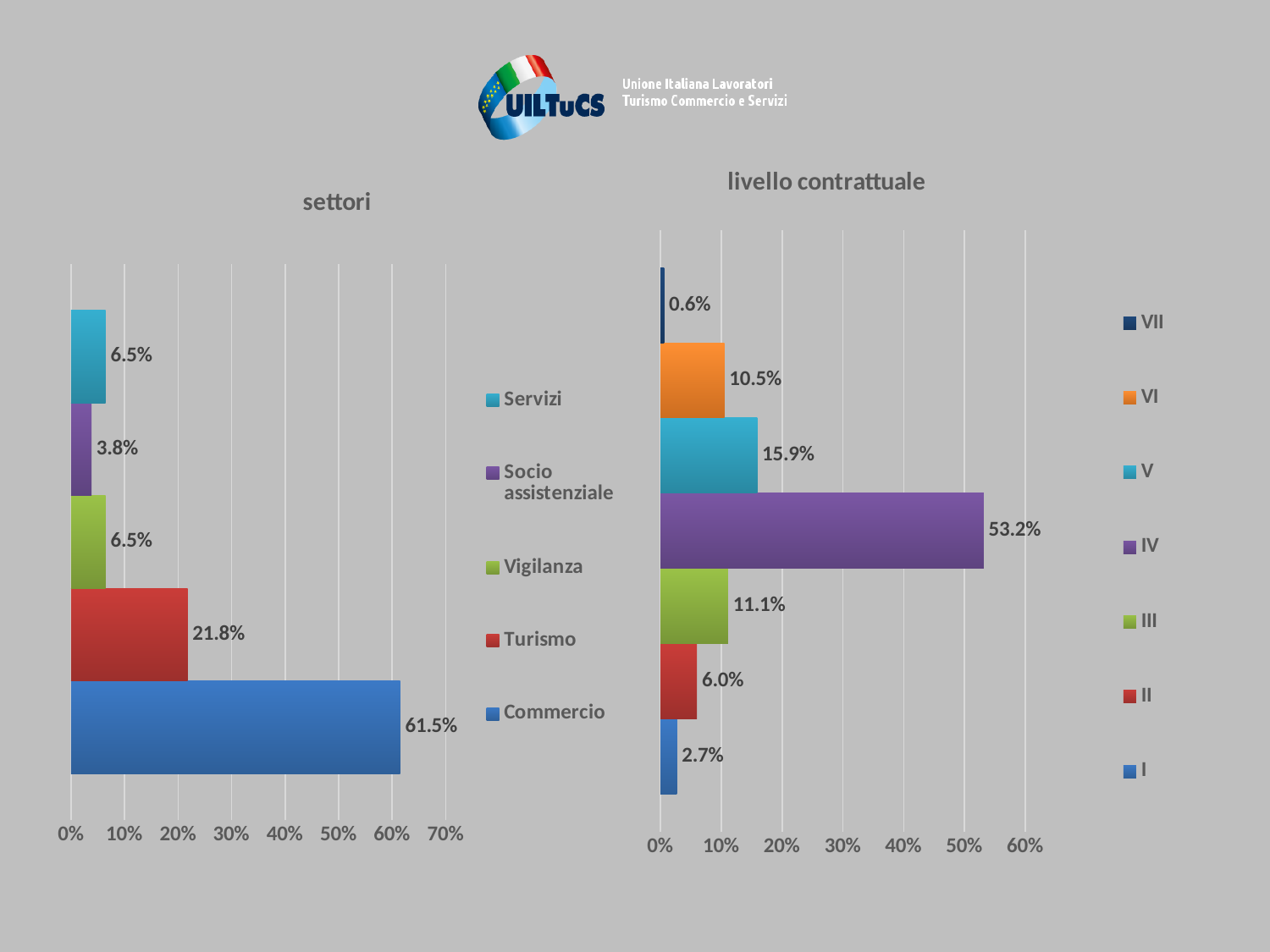
In the 'livello contrattuale' chart, which is larger, level V or level VI? V In the 'livello contrattuale' chart, how many levels does the legend list? 7 In the 'settori' chart, which sector has the lowest value? Socio assistenziale In the 'settori' chart, what is the value for Commercio? 61.5% In the 'livello contrattuale' chart, which level has the highest value? IV In the 'settori' chart, what is the difference between Commercio and Turismo? 39.7% In the 'livello contrattuale' chart, what is the value for level VII? 0.6% In the 'livello contrattuale' chart, what is the value for level IV? 53.2% In the 'settori' chart, what is the value for Turismo? 21.8% In the 'livello contrattuale' chart, what is the difference between level V and level III? 4.8% In the 'settori' chart, how many sectors are shown? 5 What kind of chart is the 'settori' chart? Bar chart